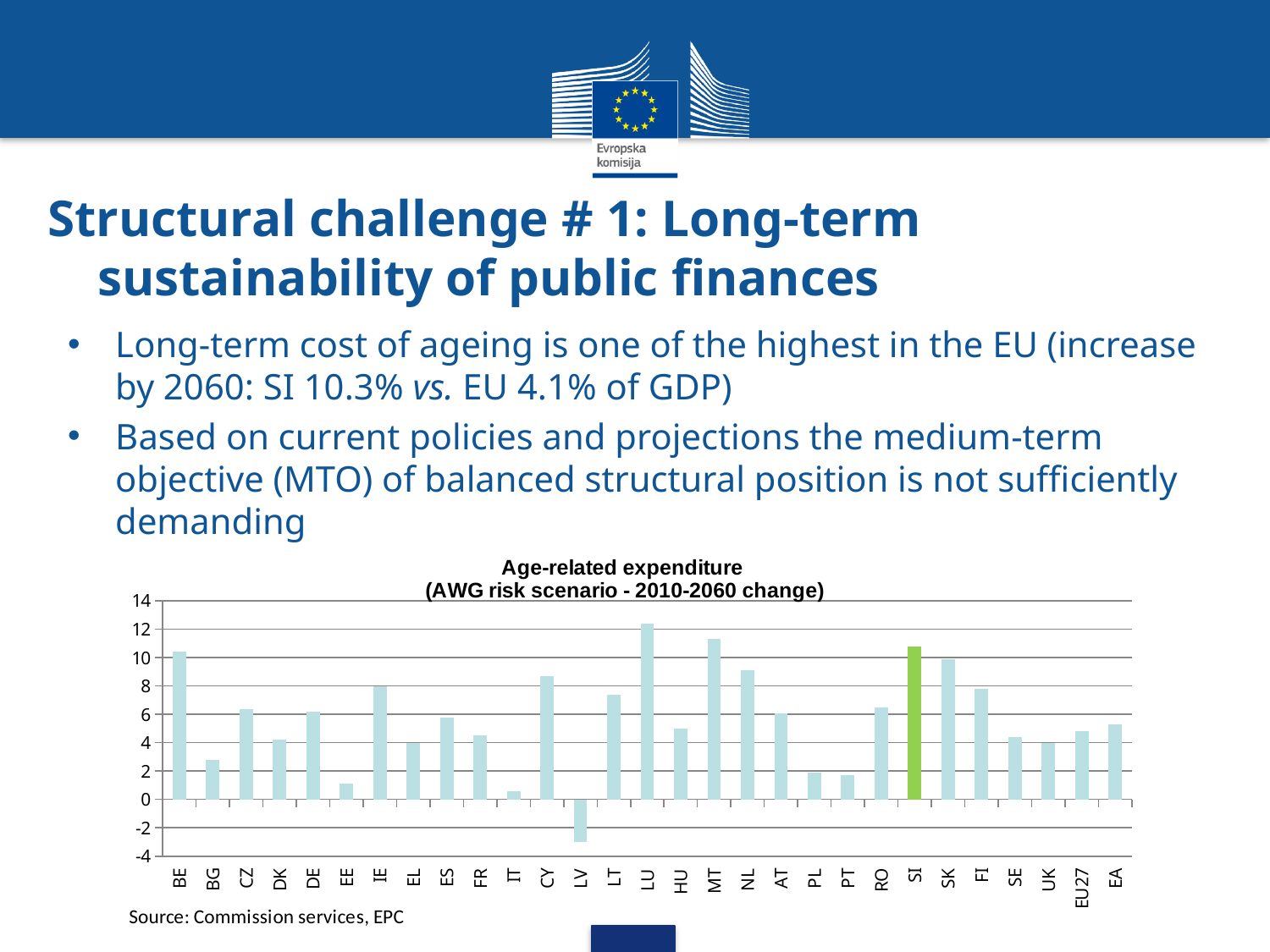
Is the value for EE greater or less than 2? less What is the title of the chart? Age-related expenditure (AWG risk scenario - 2010-2060 change) Which has the larger value, FI or SE? FI Which category has the lowest value in the chart? LV What kind of chart is shown on the slide? bar chart Which has the larger value, NL or AT? NL Is the value for MT greater or less than 10? greater How many categories are shown on the x axis? 29 Which category is highlighted with a green bar? SI Is the value for LV greater or less than 0? less Which category has the highest value in the chart? LU